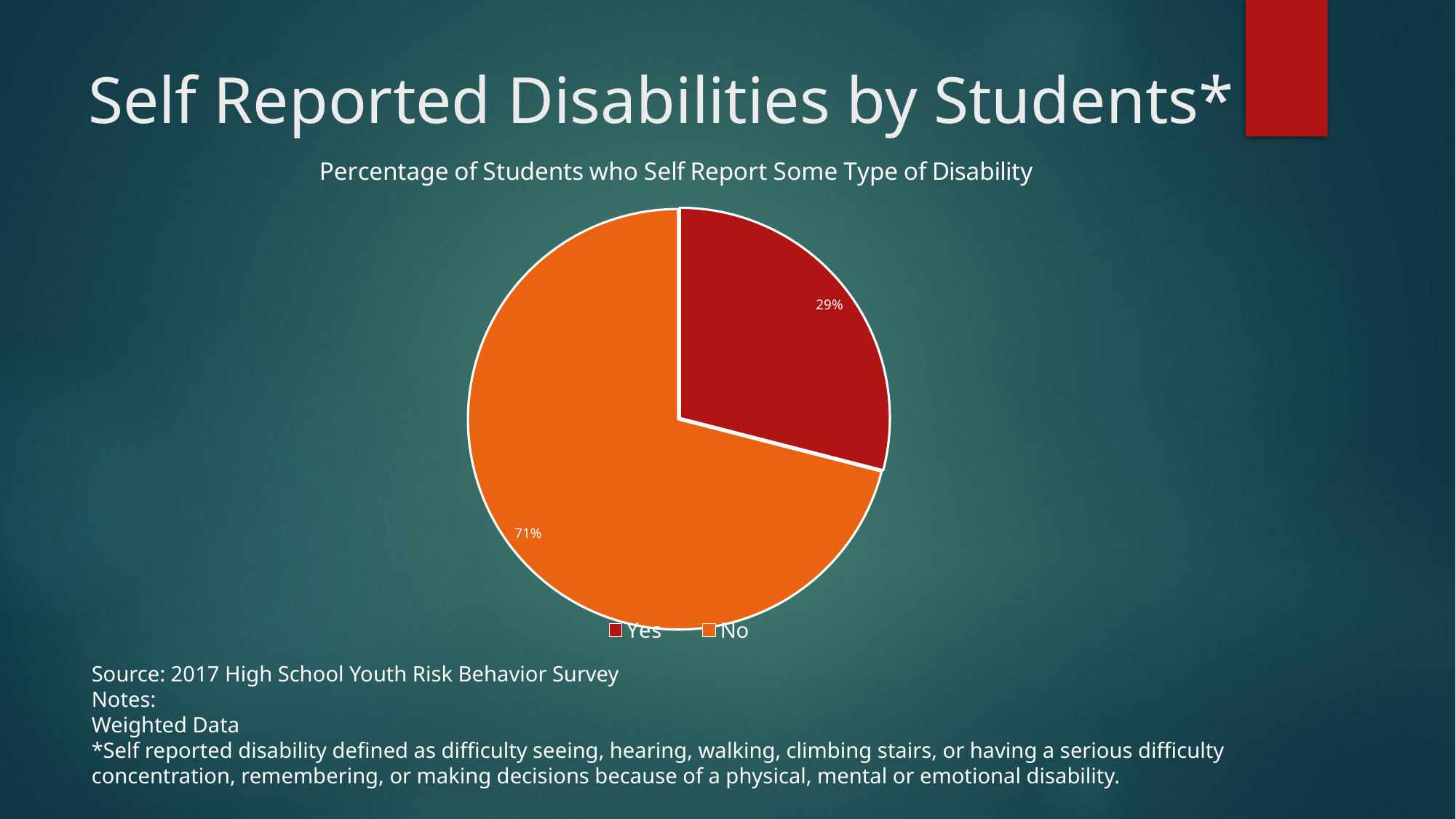
What percentage of students answered No? 71% Which is larger, the Yes slice or the No slice? No Which category has the smallest share of the pie? Yes What colour is the Yes slice in the pie chart? dark red What type of chart is shown on the slide? pie chart What is the difference in percentage points between the No and Yes slices? 42 Which category has the largest share of the pie? No What share of the pie does the Yes slice represent? 29% How many entries does the legend list? 2 How many slices does the pie chart have? 2 What percentage of students answered Yes? 29% What is the title of the chart? Percentage of Students who Self Report Some Type of Disability